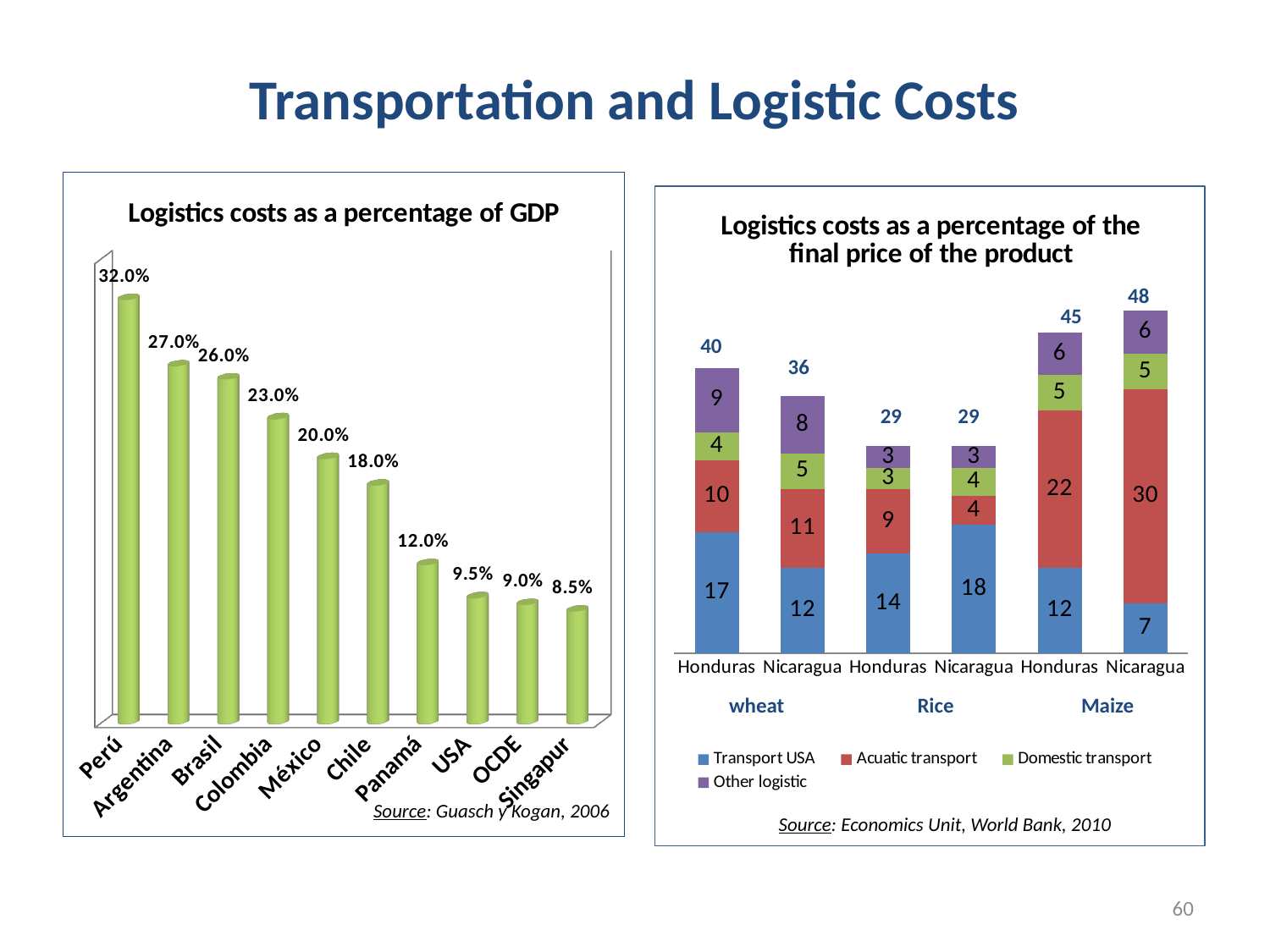
In the chart 'Logistics costs as a percentage of GDP', which country has the highest value? Perú In the chart 'Logistics costs as a percentage of GDP', do the values rise or fall from left to right? fall In the chart 'Logistics costs as a percentage of the final price of the product', what is the Acuatic transport value for Maize in Nicaragua? 30 In the chart 'Logistics costs as a percentage of the final price of the product', what is the difference between the totals for Maize in Nicaragua and Maize in Honduras? 3 In the chart 'Logistics costs as a percentage of GDP', how many countries or regions are shown? 10 In the chart 'Logistics costs as a percentage of the final price of the product', which is larger: the Transport USA value for Rice in Nicaragua or for Rice in Honduras? Rice in Nicaragua In the chart 'Logistics costs as a percentage of GDP', which category has the lowest value? Singapur In the chart 'Logistics costs as a percentage of the final price of the product', how many series does the legend list? 4 In the chart 'Logistics costs as a percentage of GDP', what is the value for Colombia? 23.0% In the chart 'Logistics costs as a percentage of the final price of the product', what is the total for the wheat Honduras bar? 40 In the chart 'Logistics costs as a percentage of GDP', what is the difference between the values for Argentina and Chile? 9.0% What kind of chart is 'Logistics costs as a percentage of the final price of the product'? stacked bar chart